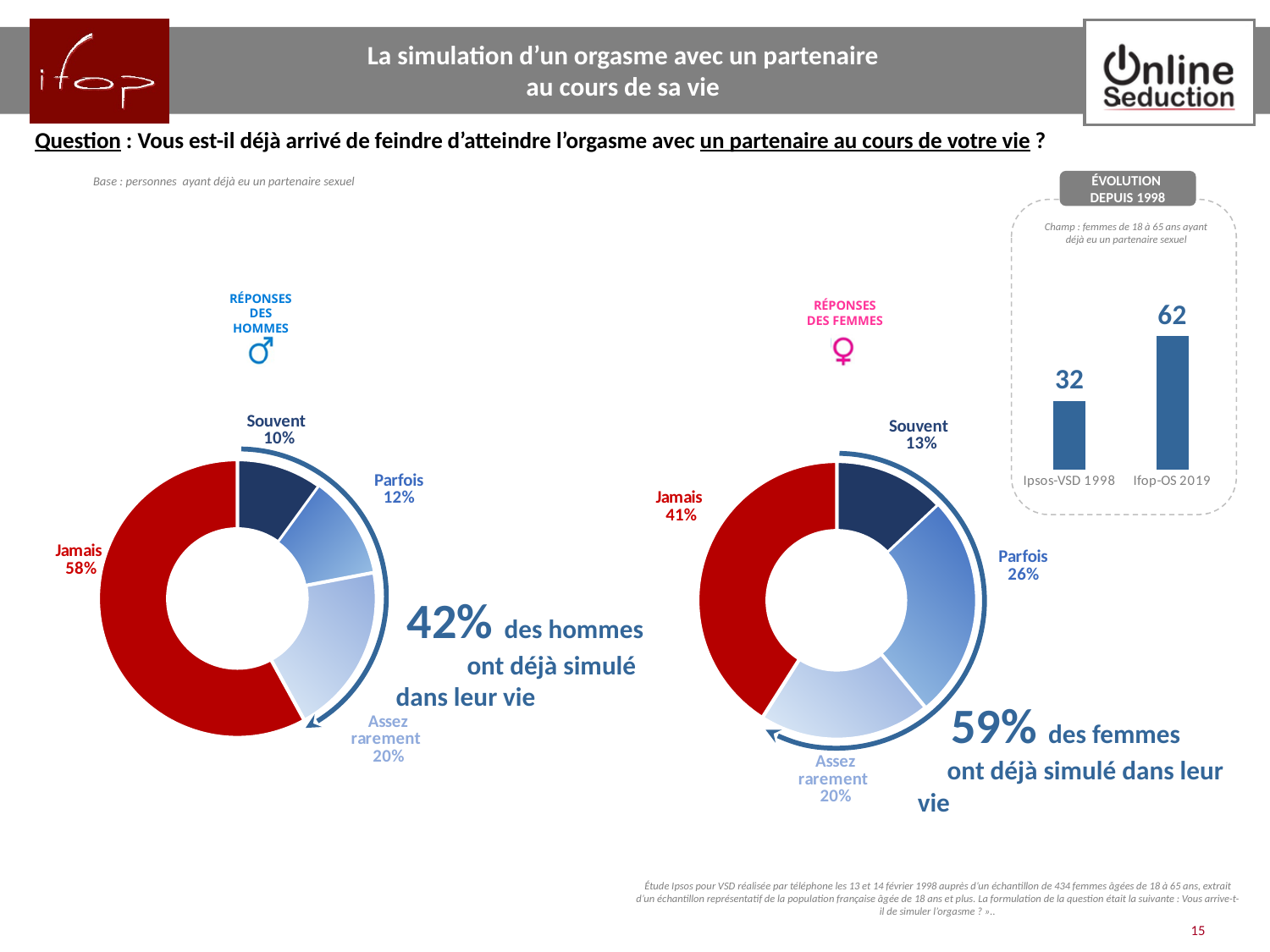
In the 'Réponses des hommes' donut chart, which category has the smallest share? Souvent How many categories does the 'Réponses des hommes' donut chart show? 4 In the 'Réponses des femmes' donut chart, what percentage of women answered 'Parfois'? 26% In the 'Réponses des hommes' donut chart, what percentage of men answered 'Jamais'? 58% What is the difference between the 'Jamais' share for men (Réponses des hommes) and for women (Réponses des femmes)? 17 points Which is larger: the 'Parfois' share in the 'Réponses des hommes' chart or in the 'Réponses des femmes' chart? Réponses des femmes In the 'Évolution depuis 1998' bar chart, do the values rise or fall from 1998 to 2019? Rise What type of chart is 'Évolution depuis 1998'? Bar chart What type of chart is used for 'Réponses des femmes'? Donut (pie) chart In the 'Évolution depuis 1998' bar chart, what is the value for Ifop-OS 2019? 62 In the 'Évolution depuis 1998' bar chart, what is the difference between the Ifop-OS 2019 and Ipsos-VSD 1998 values? 30 In the 'Réponses des femmes' donut chart, which category has the largest share? Jamais